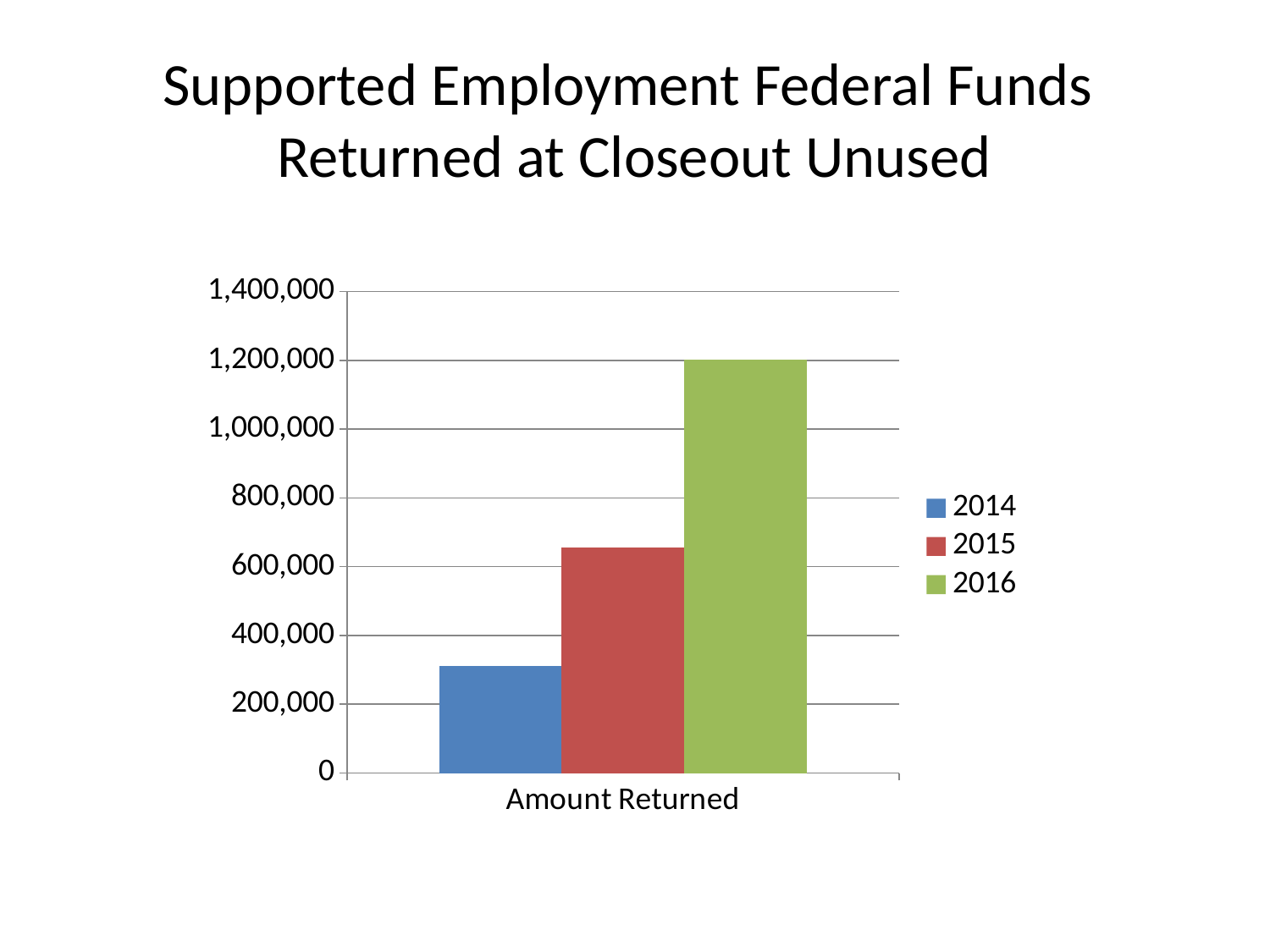
Which year has the highest amount returned? 2016 What is the label of the category on the x axis? Amount Returned Is the amount returned for 2016 greater or less than 1,000,000? greater How many categories are shown on the x axis? 1 Is the amount returned for 2015 greater or less than 600,000? greater Is the amount returned for 2014 greater or less than 400,000? less How many series does the legend list? 3 Which is larger, the amount returned for 2015 or for 2014? 2015 Which year has the lowest amount returned? 2014 What kind of chart is shown on the slide? bar chart